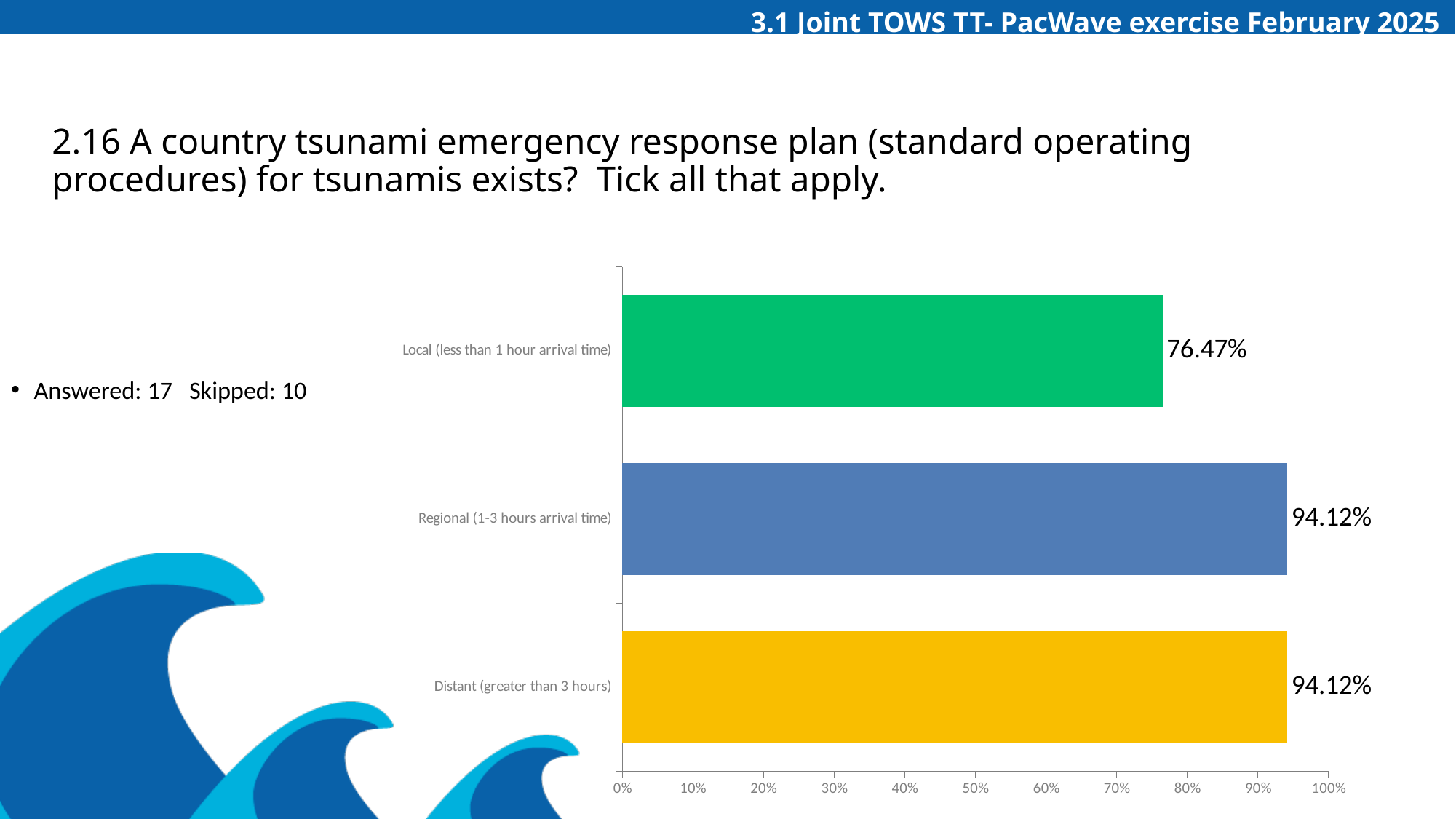
Which is larger, the value for Local (less than 1 hour arrival time) or the value for Distant (greater than 3 hours)? Distant (greater than 3 hours) What is the maximum value shown on the x axis? 100% What colour is the bar for Distant (greater than 3 hours)? Yellow Which category has the lowest value? Local (less than 1 hour arrival time) Is the value for Regional (1-3 hours arrival time) greater or less than 90%? greater What is the value for Distant (greater than 3 hours)? 94.12% Is the value for Local (less than 1 hour arrival time) greater or less than 80%? less What is the difference between the values for Regional (1-3 hours arrival time) and Local (less than 1 hour arrival time)? 17.65% How many categories are shown in the chart? 3 What is the value for Local (less than 1 hour arrival time)? 76.47% What is the value for Regional (1-3 hours arrival time)? 94.12% What kind of chart is shown on the slide? Bar chart